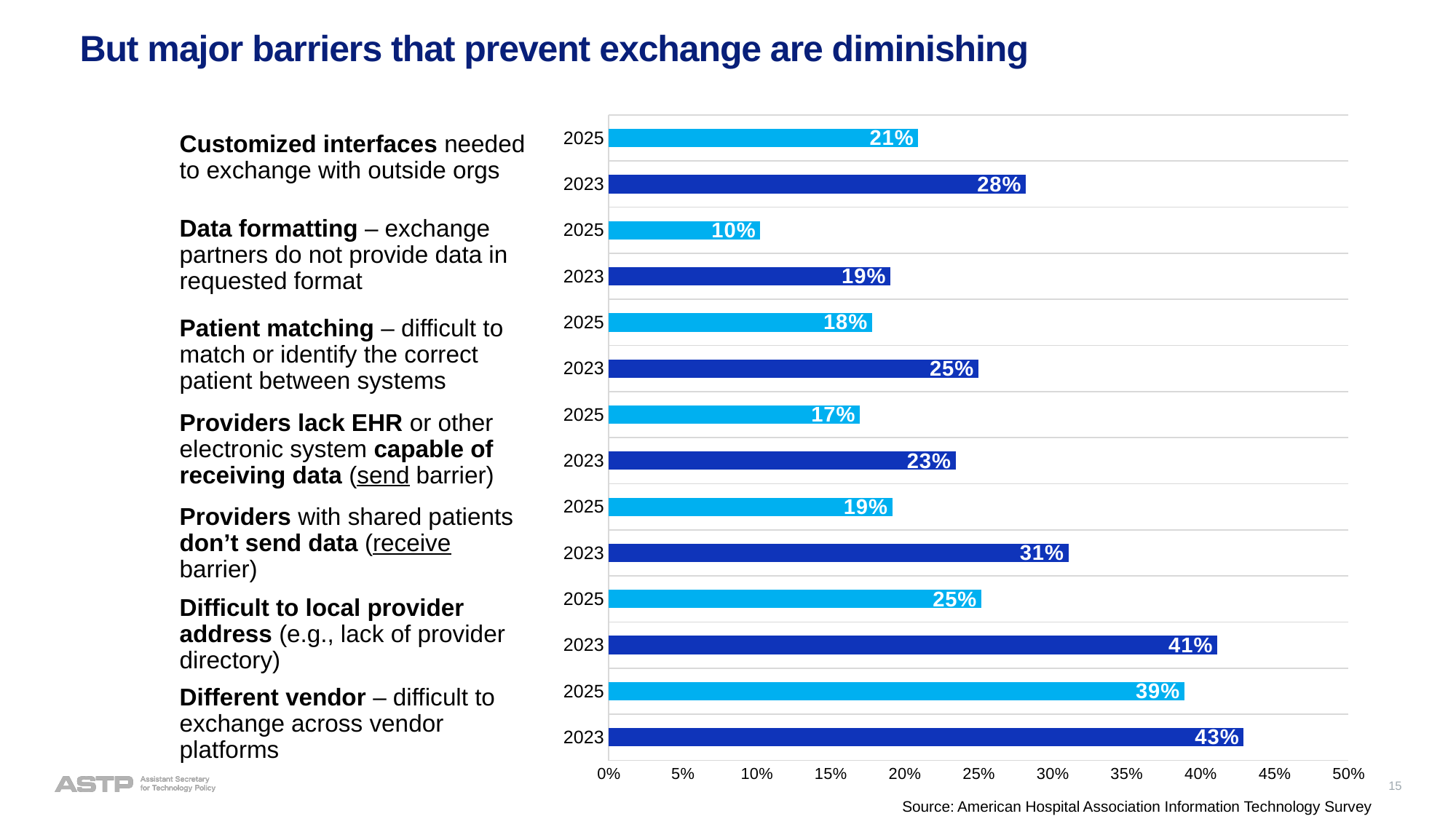
Which barrier has the highest 2023 value? Different vendor What kind of chart is shown on the slide? bar chart What is the 2023 value for the Data formatting barrier? 19% What is the difference between the 2023 and 2025 values for the Patient matching barrier? 7% Which is larger: the 2025 value for Providers lack EHR (send barrier) or the 2025 value for Providers with shared patients don't send data (receive barrier)? Providers with shared patients don't send data (receive barrier) What is the difference between the 2023 and 2025 values for the Difficult to local provider address barrier? 16% What is the maximum value shown on the horizontal axis? 50% How many barriers are shown in the chart? 7 What is the 2023 value for the Difficult to local provider address barrier? 41% Which barrier has the lowest 2025 value? Data formatting What is the 2025 value for the Customized interfaces barrier? 21% What is the 2025 value for the Different vendor barrier? 39%